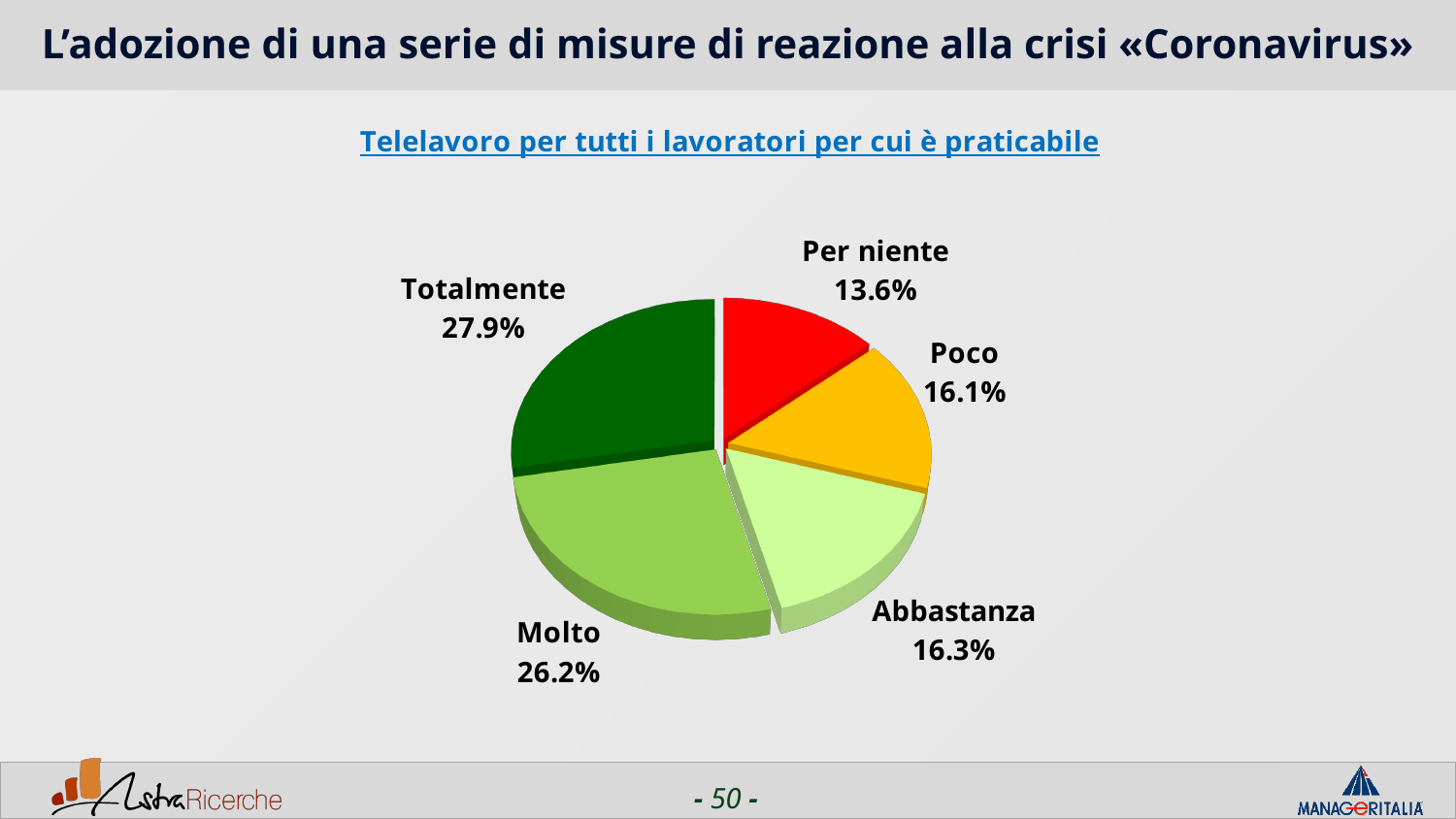
Which is larger, the value for "Abbastanza" or the value for "Poco"? Abbastanza Which category has the largest share of the pie? Totalmente What is the value for "Per niente"? 13.6% What is the value for "Molto"? 26.2% What colour is the "Per niente" slice? Red How many categories does the pie chart show? 5 What is the title of the chart? Telelavoro per tutti i lavoratori per cui è praticabile What kind of chart is shown on the slide? Pie chart What is the difference between the values for "Totalmente" and "Molto"? 1.7% Which category has the smallest share of the pie? Per niente What is the value for "Poco"? 16.1% What is the value for "Totalmente"? 27.9%